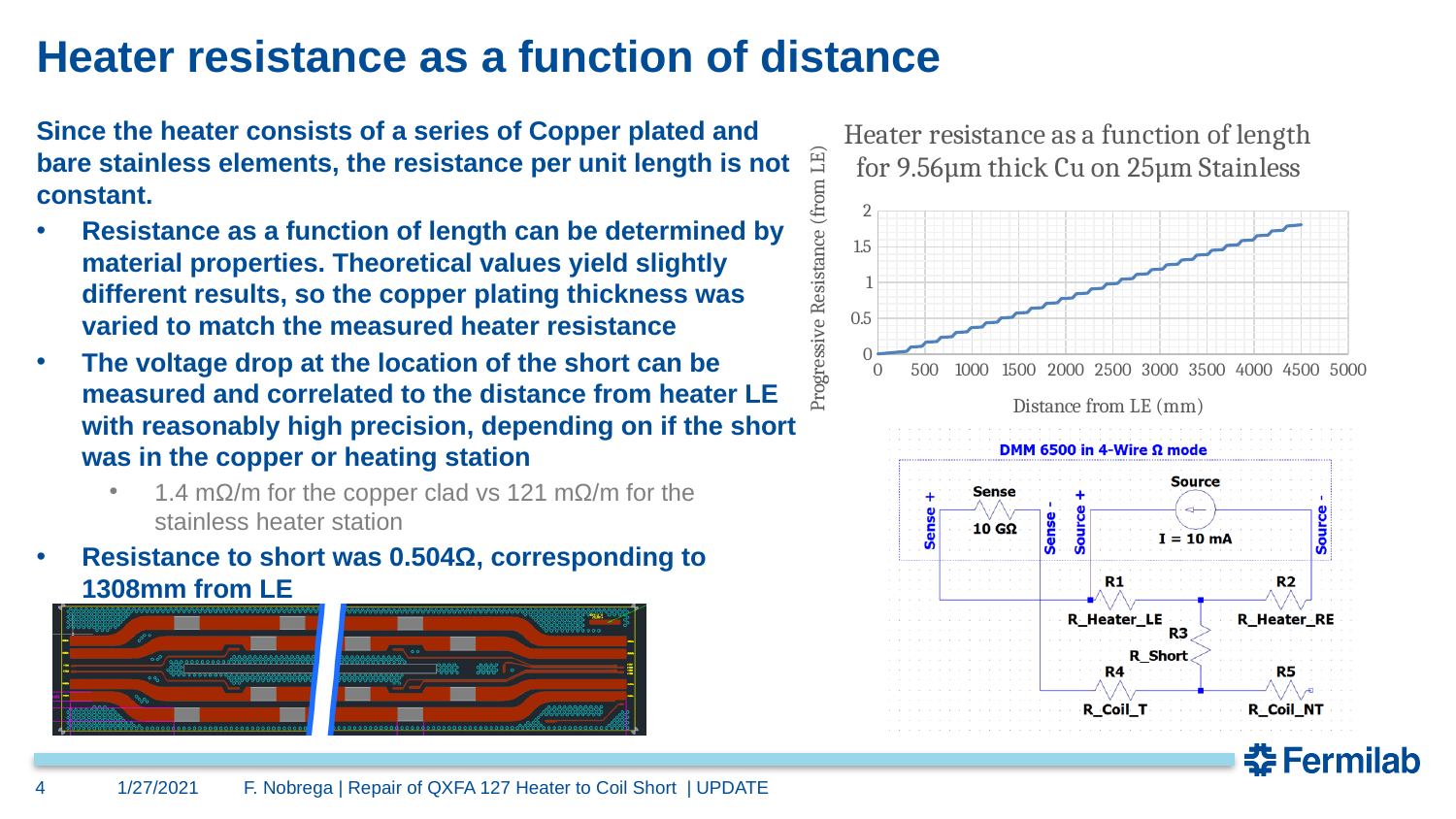
What kind of chart is shown on the slide? line chart What is the title of the chart? Heater resistance as a function of length for 9.56μm thick Cu on 25μm Stainless Is the progressive resistance at 2000 mm greater or less than 1? less Which has the higher progressive resistance, 1500 mm or 3500 mm from LE? 3500 mm Is the progressive resistance at 4000 mm greater or less than 1? greater Is the progressive resistance at 4500 mm greater or less than 1.5? greater Does the progressive resistance rise or fall as the distance from LE increases? rise What is the label of the x axis of the chart? Distance from LE (mm)